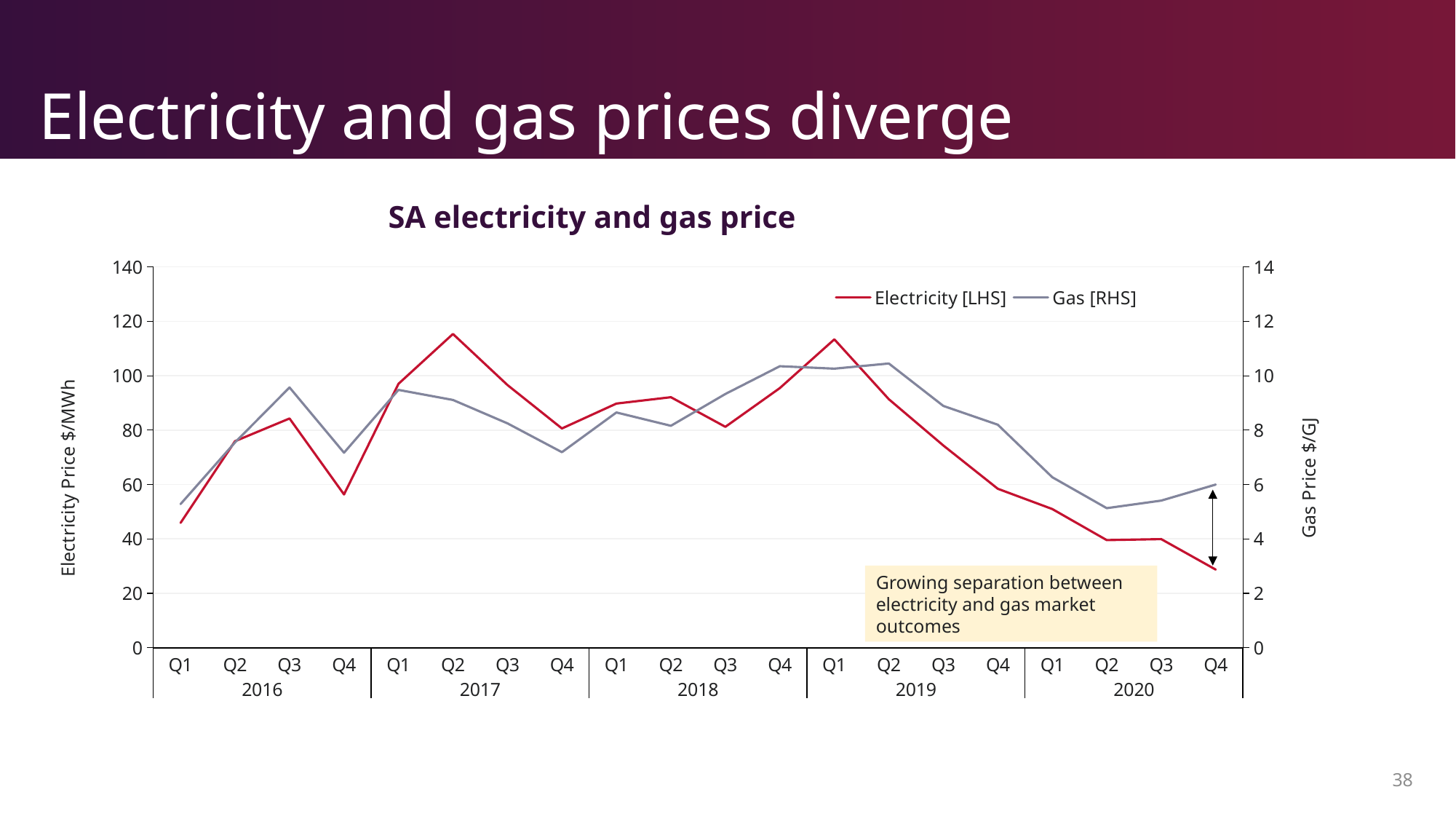
Is the gas price in Q2 2020 greater or less than 6? less How many series does the legend list? 2 How many quarterly data points are plotted for each series? 20 Is the electricity price in Q4 2020 greater or less than 40? less Is the electricity price in Q1 2016 greater or less than 60? less What is the title of the chart? SA electricity and gas price What is the label of the right-hand vertical axis? Gas Price $/GJ What kind of chart is shown on the slide? line chart Does the electricity price rise or fall from Q1 2019 to Q4 2020? fall Which quarter has the lowest electricity price? Q4 2020